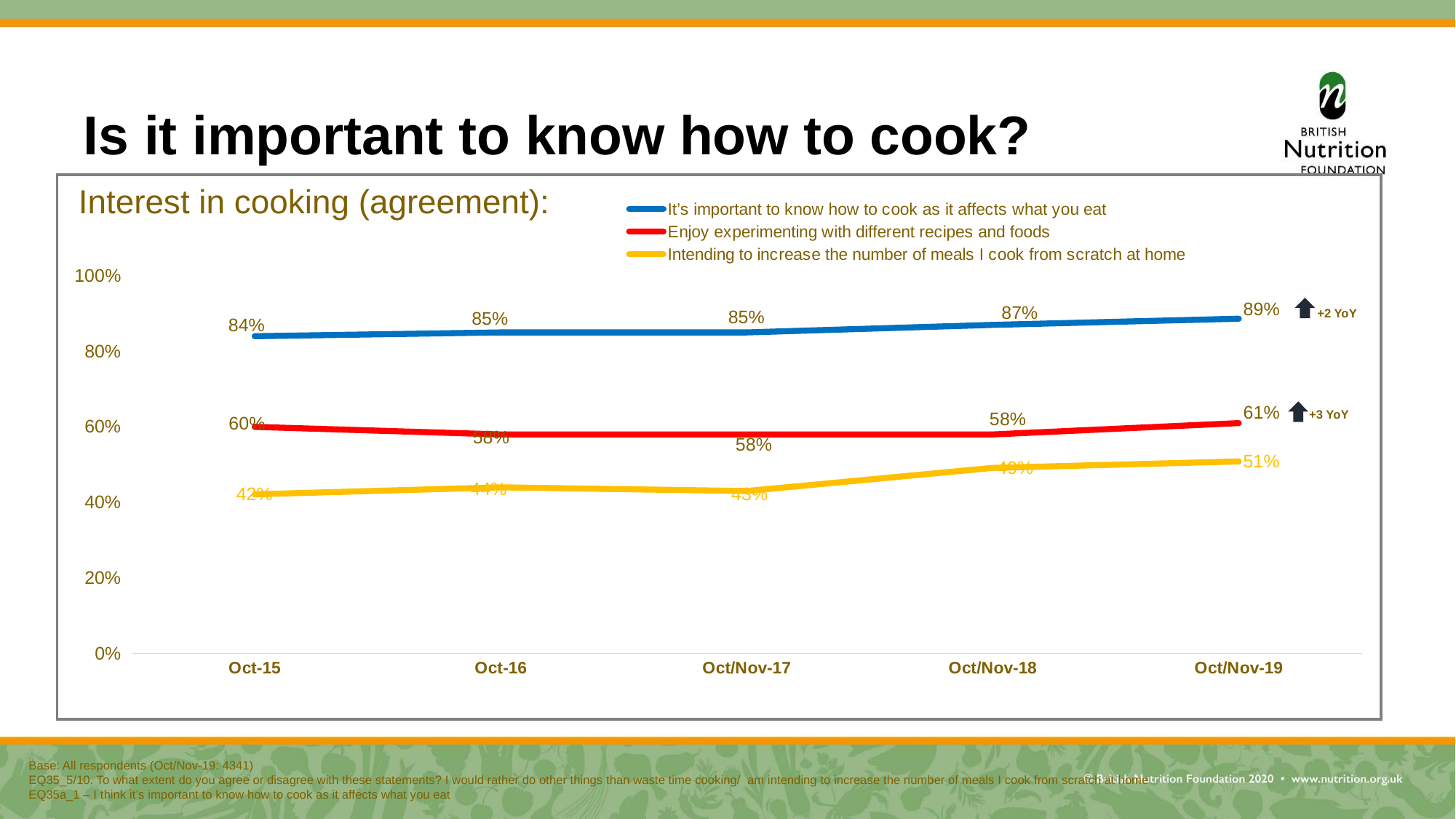
How many time points are shown on the x axis? 5 What colour is the line for 'Enjoy experimenting with different recipes and foods'? red Which series has the highest values across all time points? It's important to know how to cook as it affects what you eat Which is larger at Oct/Nov-19: 'Enjoy experimenting with different recipes and foods' or 'Intending to increase the number of meals I cook from scratch at home'? Enjoy experimenting with different recipes and foods What type of chart is shown on the slide? line chart How many series does the legend list? 3 What is the value for 'It's important to know how to cook as it affects what you eat' at Oct/Nov-19? 89% What is the value for 'It's important to know how to cook as it affects what you eat' at Oct/Nov-18? 87% What is the value for 'Intending to increase the number of meals I cook from scratch at home' at Oct/Nov-19? 51% What is the difference between the 'It's important to know how to cook' value at Oct/Nov-19 and at Oct-15? 5% Does the 'Intending to increase the number of meals I cook from scratch at home' series rise or fall from Oct-15 to Oct/Nov-19? rise What is the value for 'Enjoy experimenting with different recipes and foods' at Oct-15? 60%